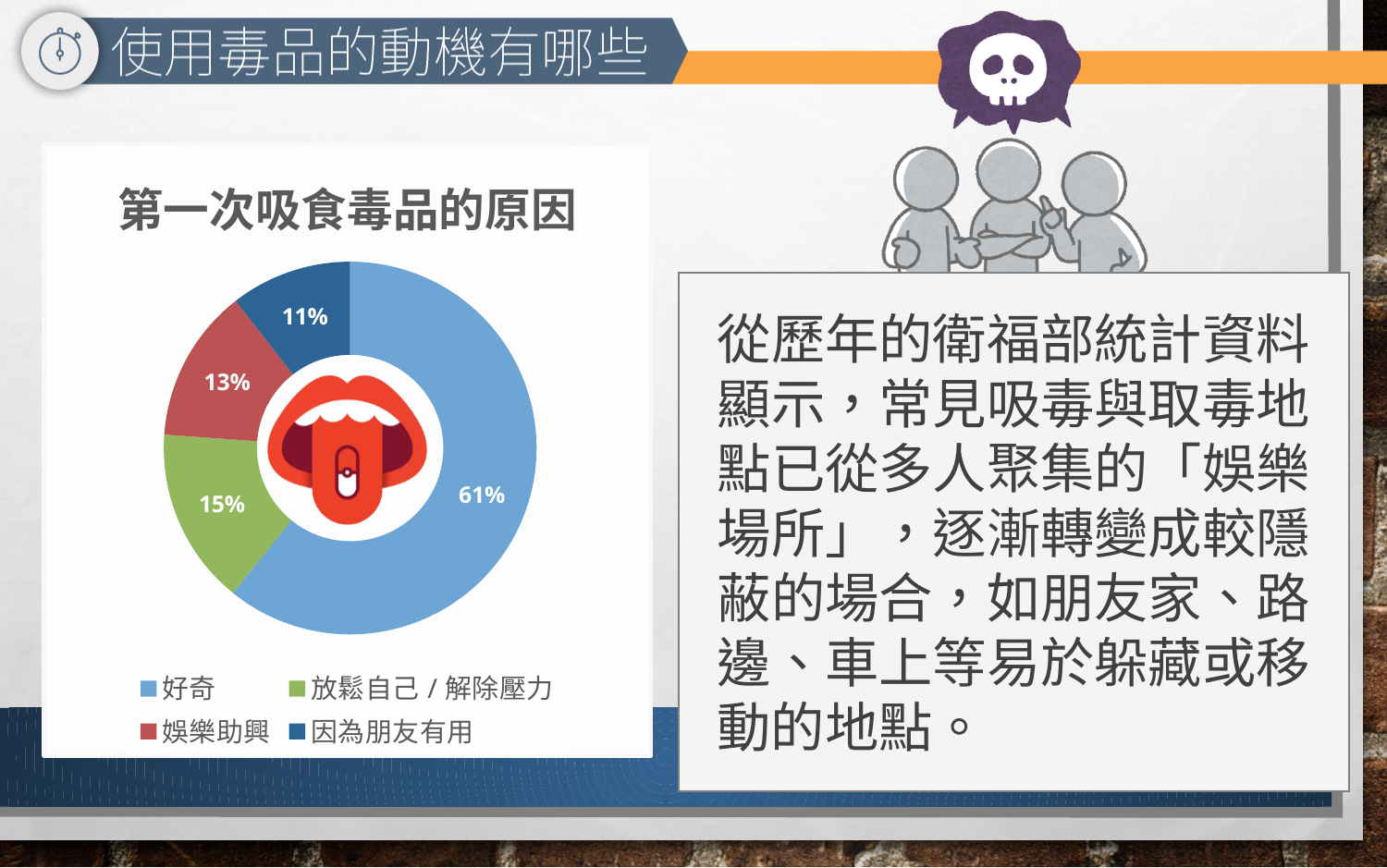
What is the title of the chart? 第一次吸食毒品的原因 Which category has the largest share of the chart? 好奇 What percentage of the chart is 好奇? 61% Which colour represents 娛樂助興 in the chart? red What is the difference in percentage points between 好奇 and 放鬆自己／解除壓力? 46 How many categories does the chart show? 4 What percentage of the chart is 娛樂助興? 13% What percentage of the chart is 因為朋友有用? 11% What kind of chart is shown on the slide? doughnut chart Which category has the smallest share of the chart? 因為朋友有用 What percentage of the chart is 放鬆自己／解除壓力? 15% Which is larger, the share for 娛樂助興 or the share for 因為朋友有用? 娛樂助興